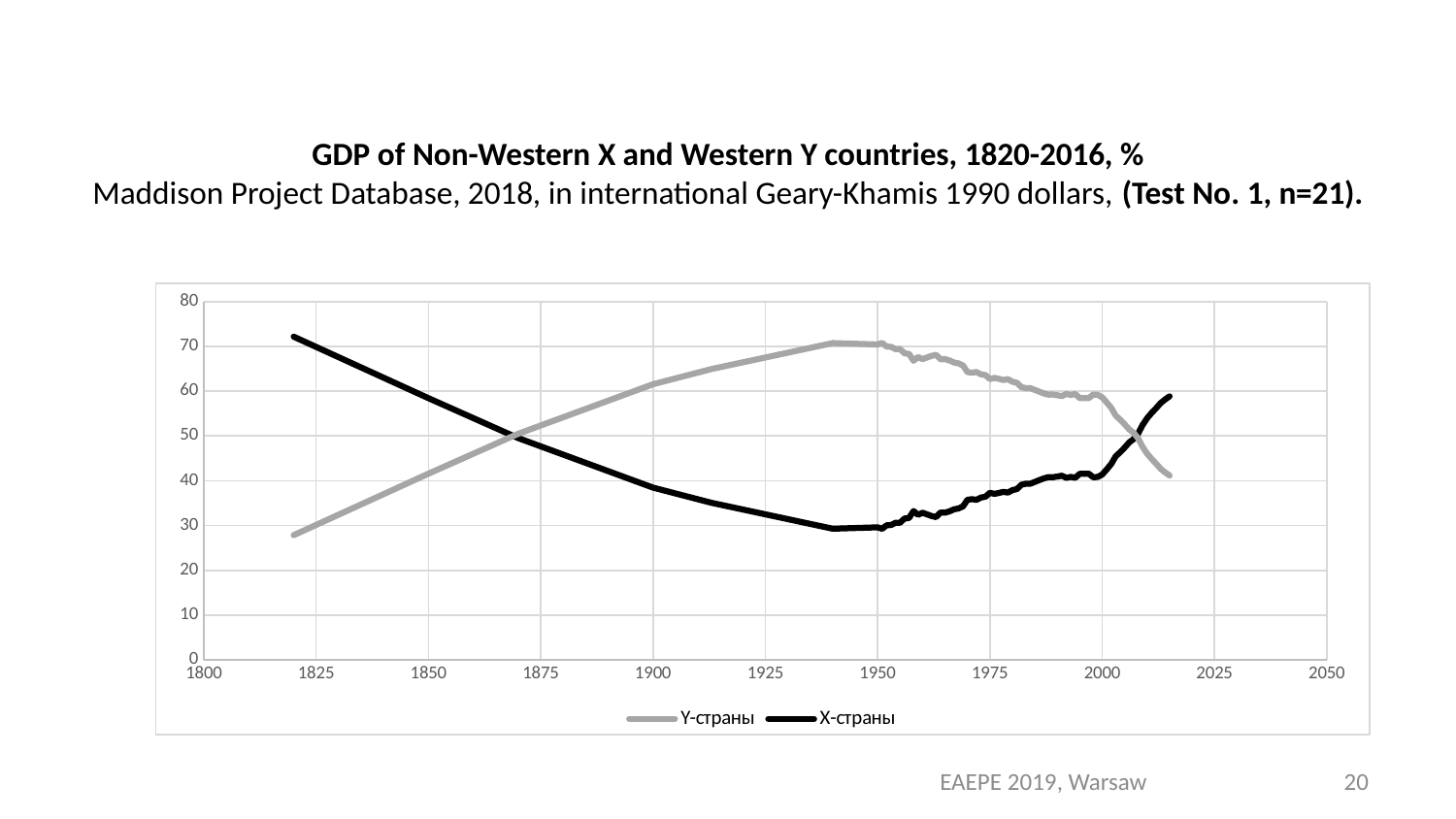
Is the value for Y-страны in 1820 greater or less than 30? less Does the Y-страны line rise or fall between 1820 and 1940? rise How many series does the legend list? 2 Is the value for X-страны in 1820 greater or less than 70? greater What are the two series named in the legend? Y-страны and X-страны In 1900, which series has the higher value, Y-страны or X-страны? Y-страны What kind of chart is shown on the slide? line chart Is the value for X-страны at the end of the series (around 2016) greater or less than 50? greater Which colour is the X-страны line drawn in? black Does the X-страны line rise or fall between 1820 and 1940? fall